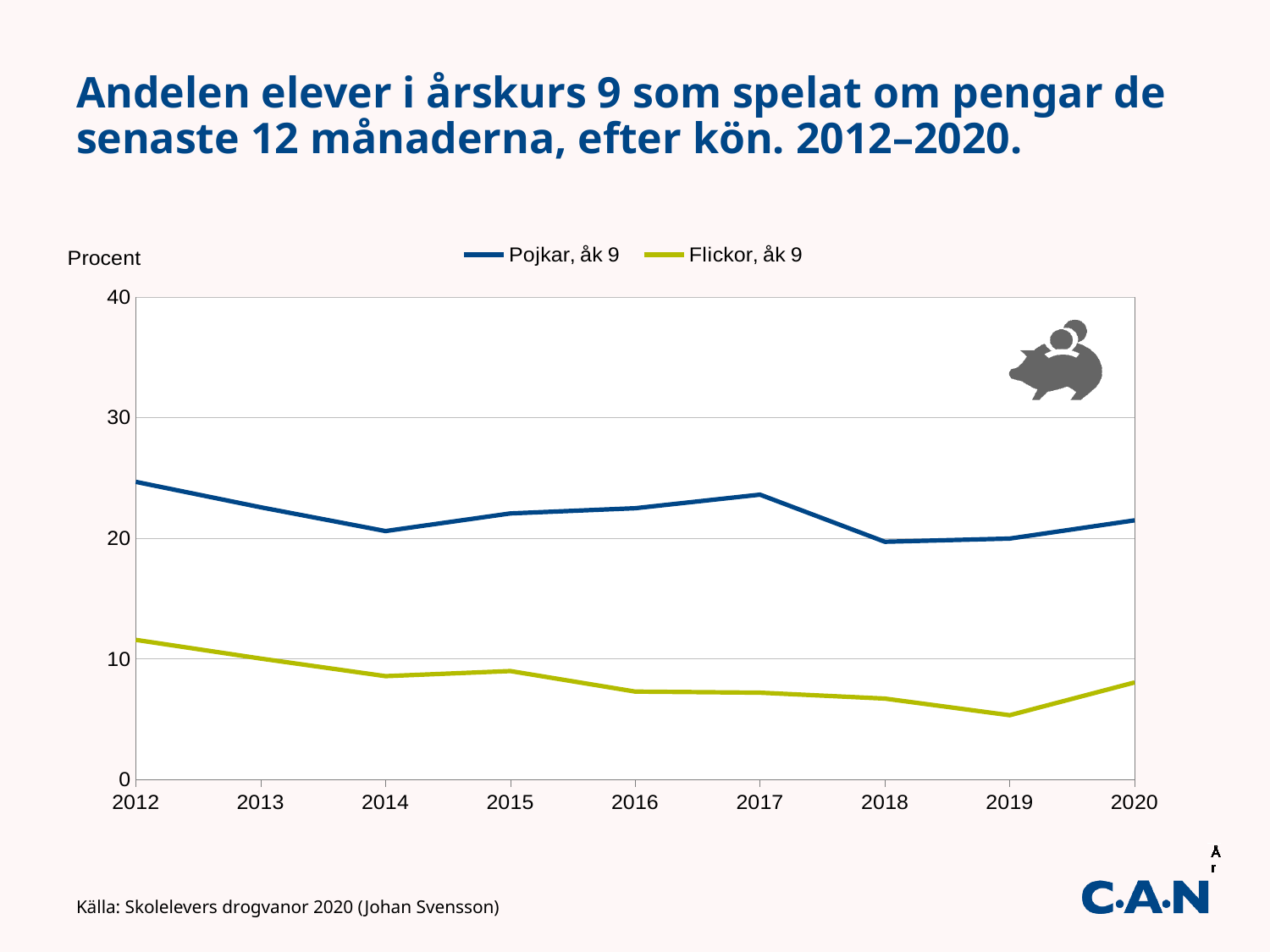
Does the value for Flickor, åk 9 rise or fall from 2012 to 2019? Fall How many series does the legend list? 2 In which year is the value for Flickor, åk 9 lowest? 2019 In which year is the value for Flickor, åk 9 highest? 2012 Which series has the larger value in 2016, Pojkar, åk 9 or Flickor, åk 9? Pojkar, åk 9 Is the value for Flickor, åk 9 in 2019 greater or less than 10? less Is the value for Flickor, åk 9 in 2012 greater or less than 10? greater How many years are plotted along the x axis? 9 What kind of chart is shown on the slide? Line chart Is the value for Pojkar, åk 9 in 2017 greater or less than 20? greater In which year is the value for Pojkar, åk 9 highest? 2012 What are the two series named in the legend? Pojkar, åk 9 and Flickor, åk 9